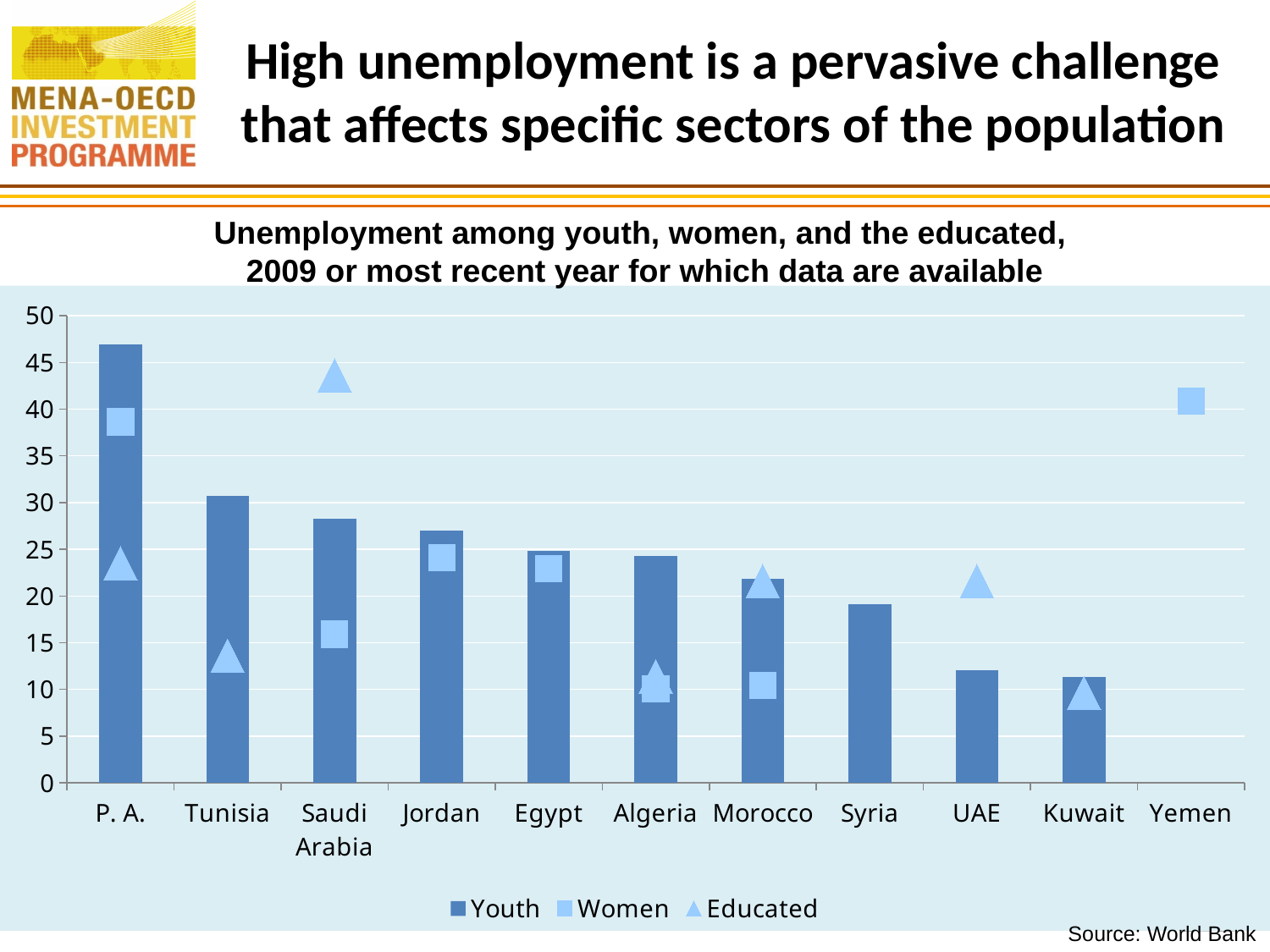
Do the Youth unemployment bars generally rise or fall from P. A. to Kuwait along the x axis? fall Is the Youth unemployment value for P. A. greater or less than 45? greater How many series does the legend list? 3 How many countries are shown on the x axis? 11 Is the Youth unemployment value for UAE greater or less than 15? less What kind of chart is shown on the slide? bar chart What source is cited for the chart? World Bank Which country has the highest Youth unemployment bar? P. A. Which is larger, the Youth unemployment bar for Tunisia or for Saudi Arabia? Tunisia Which country has the highest Educated unemployment marker? Saudi Arabia Is the Women unemployment value for Yemen greater or less than 35? greater